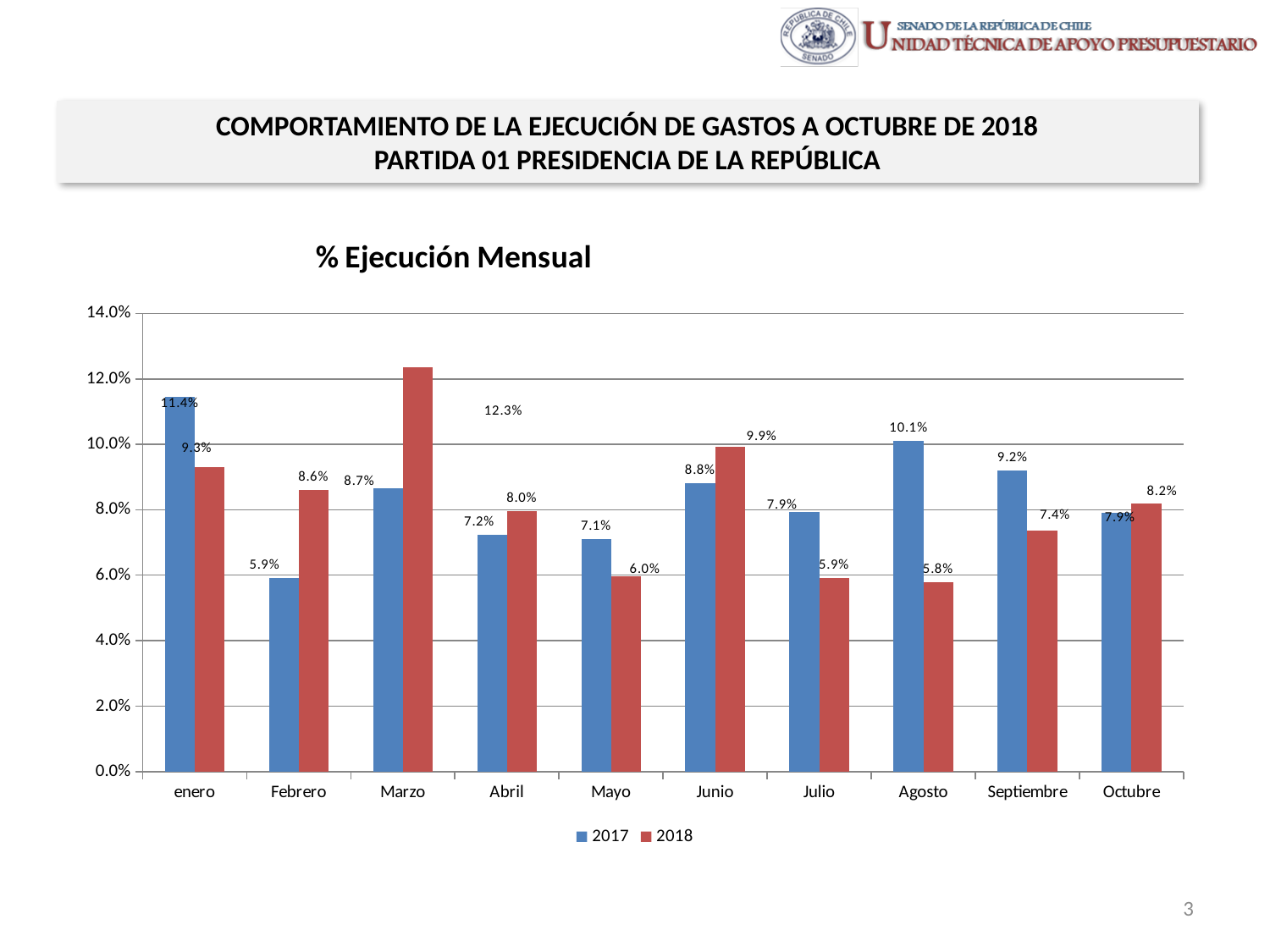
How many series does the legend list? 2 What is the value for 2017 in Septiembre? 9.2% Which month has the highest value for the 2018 series? Marzo Which month has the lowest value for the 2017 series? Febrero What is the value for 2018 in Agosto? 5.8% What is the value for 2018 in Marzo? 12.3% What kind of chart is shown on the slide? Bar chart How many months are shown on the x axis? 10 What is the title of the chart? % Ejecución Mensual What is the difference between the 2017 and 2018 values in Agosto? 4.3% What is the value for 2017 in enero? 11.4% Which is larger in Julio, the 2017 value or the 2018 value? 2017